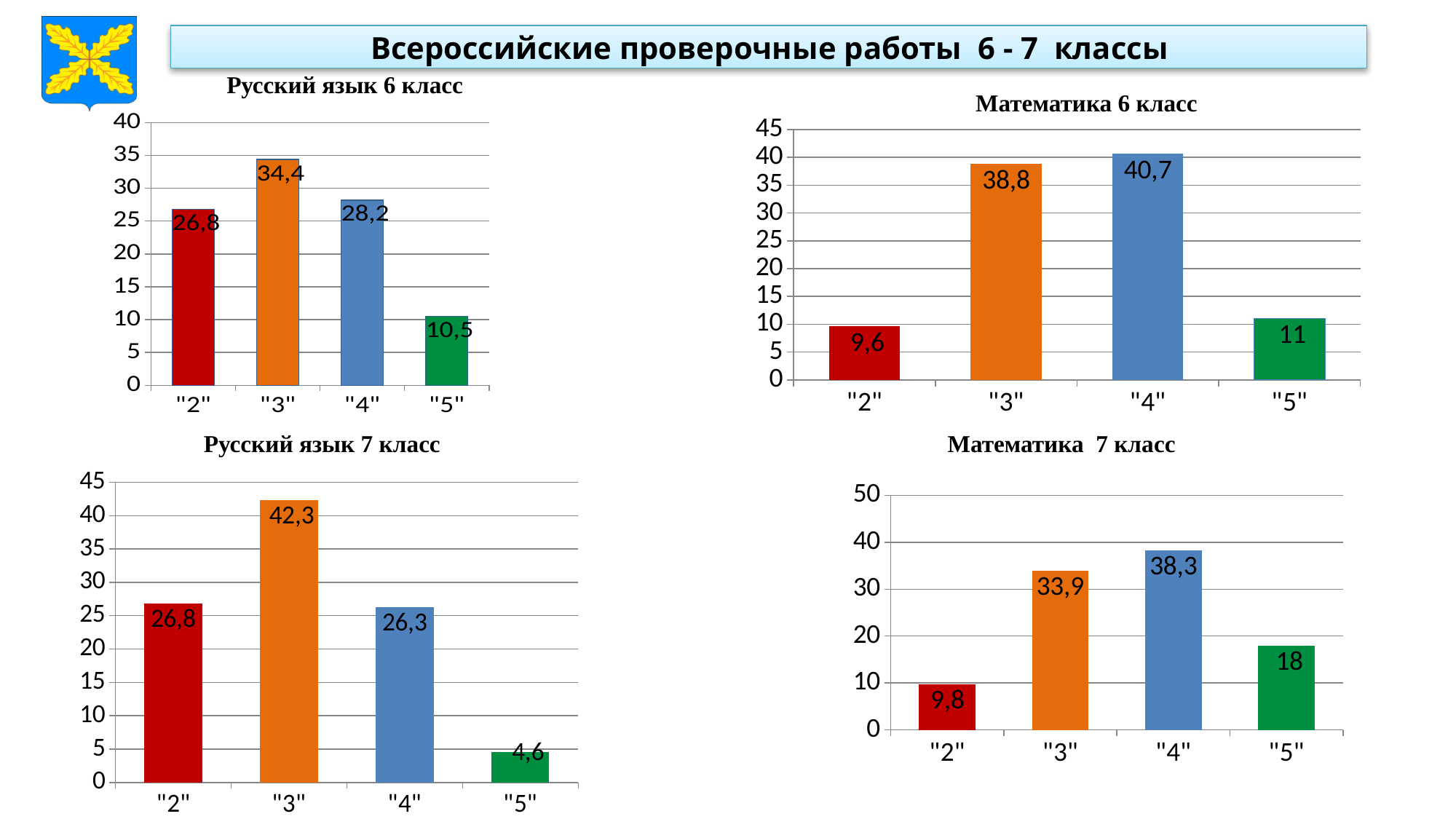
In the "Русский язык 6 класс" chart, what is the difference between the values for "3" and "2"? 7,6 What kind of chart is "Русский язык 7 класс"? bar chart What is the title of the chart in the top-right of the slide? Математика 6 класс In the "Математика 7 класс" chart, what is the value for "5"? 18 In the "Математика 6 класс" chart, what is the difference between the values for "4" and "3"? 1,9 In the "Математика 7 класс" chart, is the value for "4" greater or less than 30? greater In the "Русский язык 6 класс" chart, what is the value for "3"? 34,4 In the "Математика 7 класс" chart, what is the difference between the values for "4" and "5"? 20,3 In the "Русский язык 7 класс" chart, which is larger: the value for "2" or the value for "4"? "2" In the "Математика 6 класс" chart, which category has the highest value? "4" How many categories are shown in the "Математика 6 класс" chart? 4 In the "Русский язык 7 класс" chart, which category has the lowest value? "5"